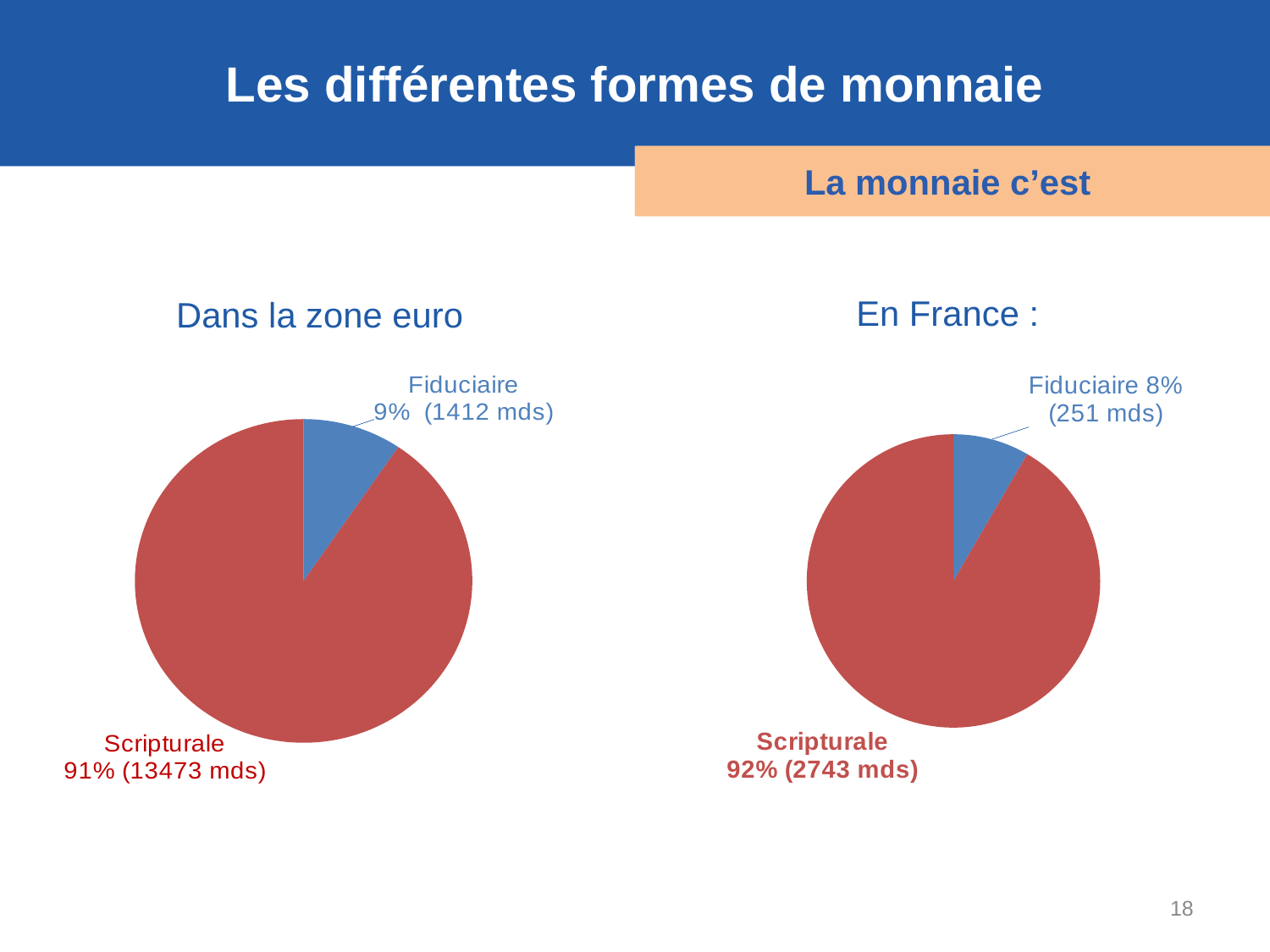
In the 'Dans la zone euro' chart, what is the difference in mds between Scripturale and Fiduciaire? 12061 mds What kind of chart is the 'En France' chart? Pie chart In the 'En France' chart, what value in mds is shown for Scripturale? 2743 mds In the 'Dans la zone euro' chart, what value in mds is shown for Fiduciaire? 1412 mds In the 'Dans la zone euro' chart, which category is the largest? Scripturale How many categories does the 'Dans la zone euro' chart show? 2 In the 'En France' chart, what share of the pie is Scripturale? 92% In the 'En France' chart, what value in mds is shown for Fiduciaire? 251 mds In the 'En France' chart, which category is the smallest? Fiduciaire In the 'En France' chart, what is the difference in percentage points between Scripturale and Fiduciaire? 84 In the 'Dans la zone euro' chart, what share of the pie is Fiduciaire? 9% In the 'Dans la zone euro' chart, what value in mds is shown for Scripturale? 13473 mds